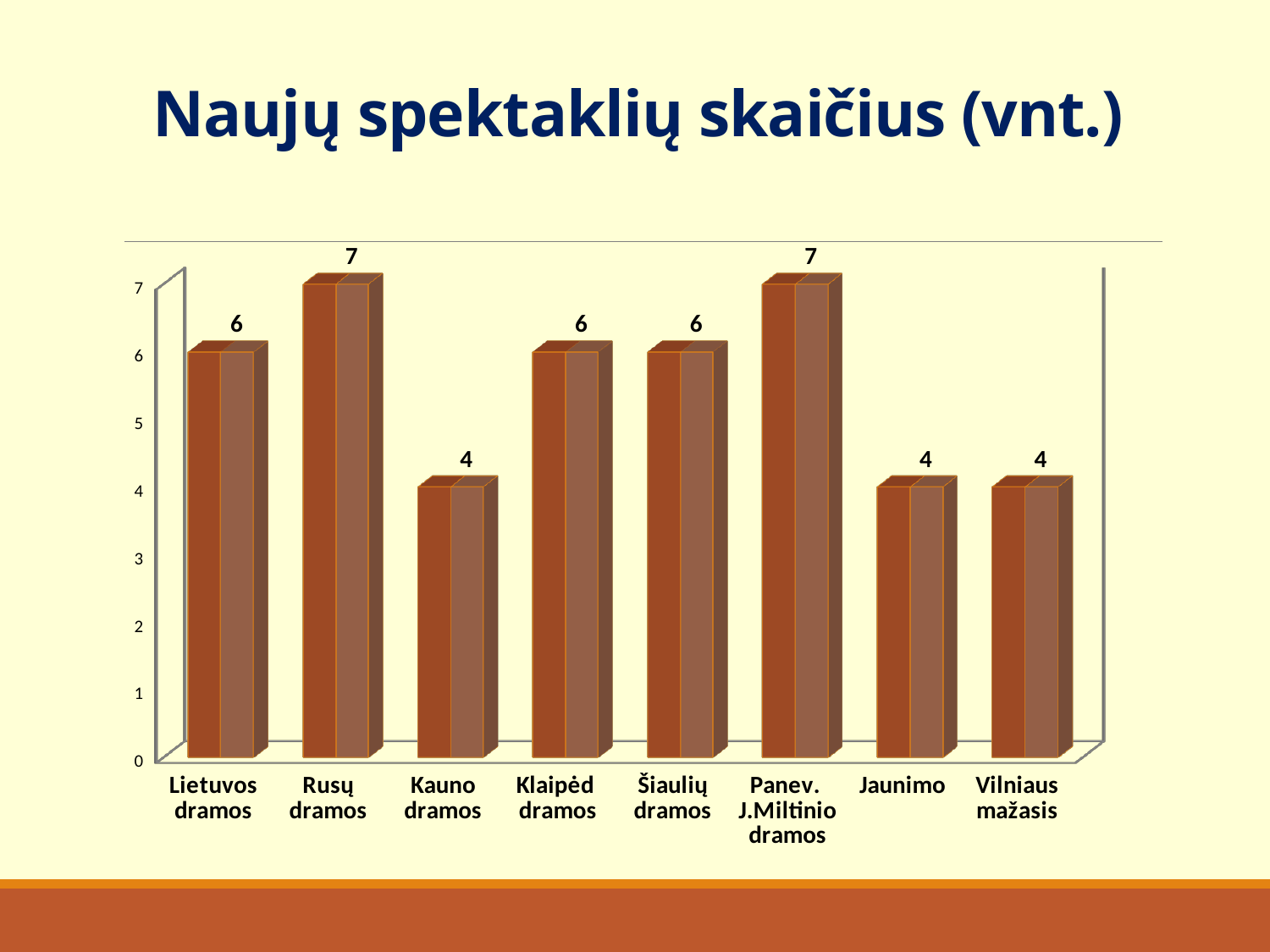
Which is larger, the value for Panev. J.Miltinio dramos or the value for Lietuvos dramos? Panev. J.Miltinio dramos What is the value for Vilniaus mažasis? 4 What is the difference between the values for Rusų dramos and Kauno dramos? 3 What kind of chart is shown on the slide? Bar chart What is the difference between the values for Šiaulių dramos and Jaunimo? 2 What is the value for Lietuvos dramos? 6 What is the value for Panev. J.Miltinio dramos? 7 How many categories are shown on the x axis? 8 Which is larger, the value for Klaipėd dramos or the value for Jaunimo? Klaipėd dramos What is the title of the chart? Naujų spektaklių skaičius (vnt.) What is the value for Rusų dramos? 7 What is the value for Kauno dramos? 4